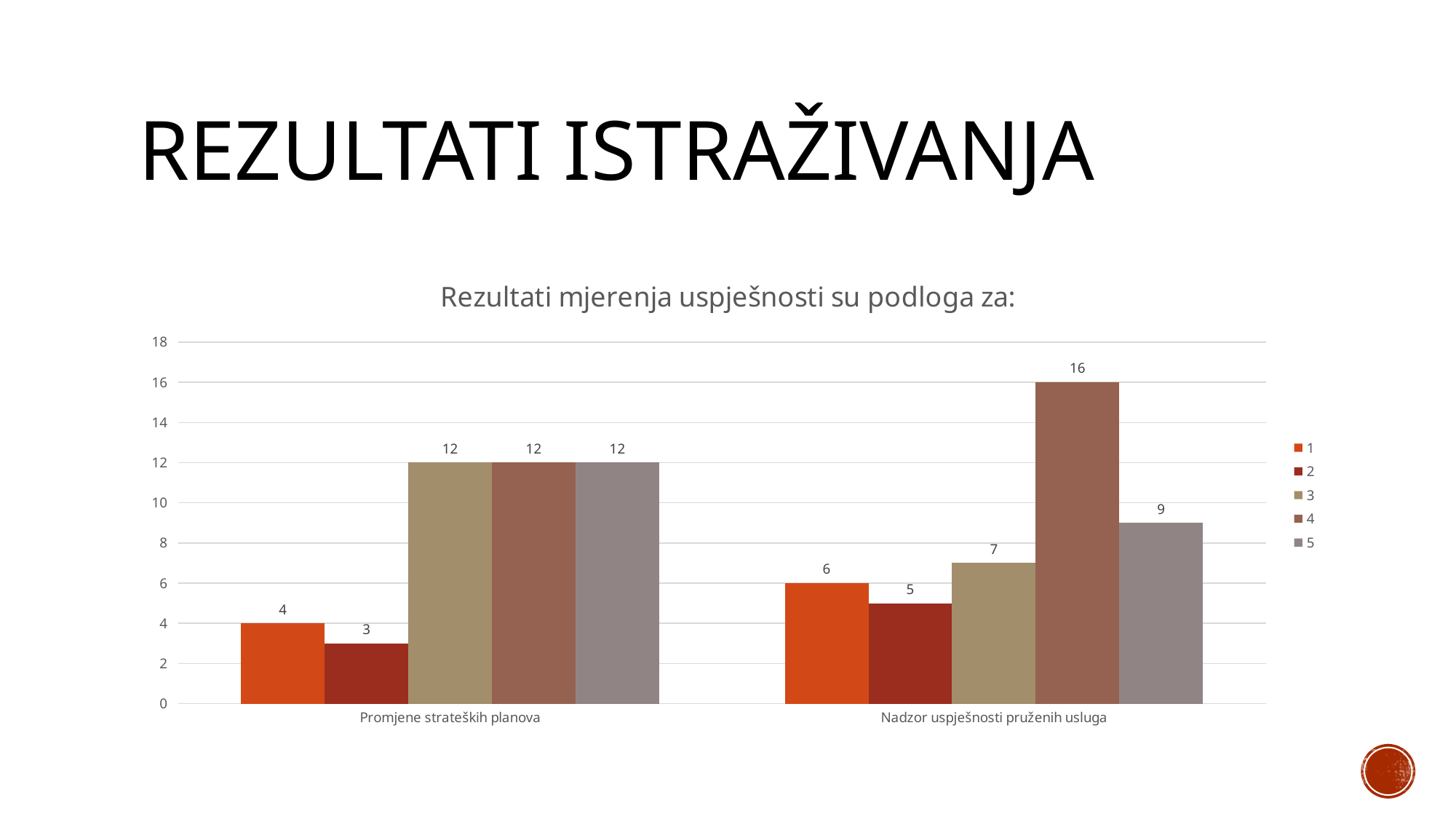
What is the value for series 5 in the "Nadzor uspješnosti pruženih usluga" category? 9 How many series does the legend list? 5 What is the value for series 2 in the "Promjene strateških planova" category? 3 Is the value for series 3 in the "Promjene strateških planova" category greater or less than 10? greater What is the value for series 4 in the "Nadzor uspješnosti pruženih usluga" category? 16 How many categories are shown on the x axis? 2 Which series has the highest value in the "Nadzor uspješnosti pruženih usluga" category? 4 What is the difference between the series 4 value and the series 5 value in the "Nadzor uspješnosti pruženih usluga" category? 7 Which series has the lowest value in the "Promjene strateških planova" category? 2 What kind of chart is shown on the slide? Bar chart What is the title of the chart? Rezultati mjerenja uspješnosti su podloga za: Which is larger: the series 1 value for "Promjene strateških planova" or the series 1 value for "Nadzor uspješnosti pruženih usluga"? Nadzor uspješnosti pruženih usluga